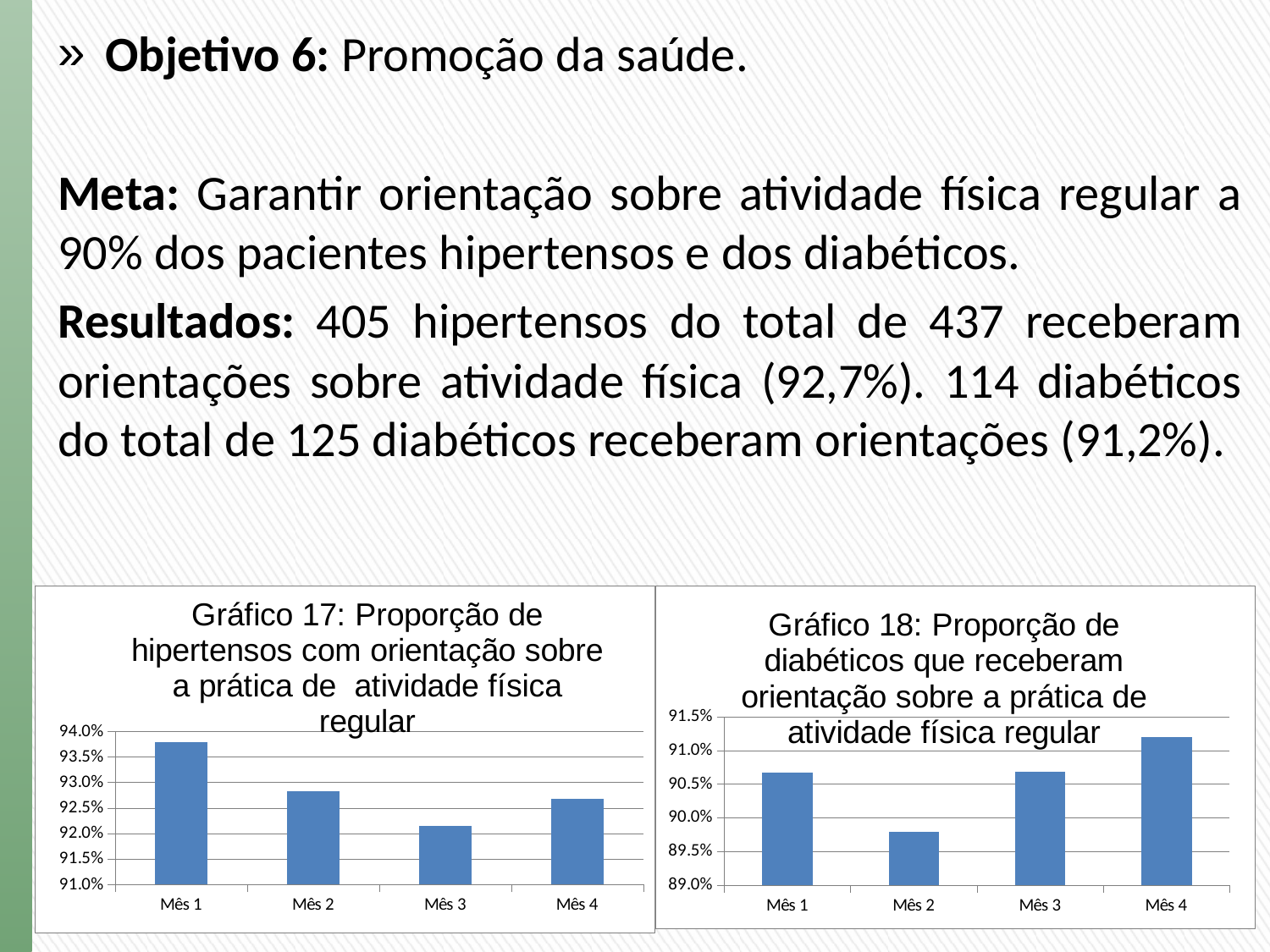
In Gráfico 17, is the value for Mês 1 greater or less than 93.5%? greater In Gráfico 17, which month has the highest proportion of hypertensive patients with guidance on physical activity? Mês 1 How many charts are shown on the slide? 2 In Gráfico 18, is the value for Mês 2 greater or less than 90.0%? less In Gráfico 18, which month has the highest proportion of diabetic patients who received guidance? Mês 4 In Gráfico 18, is the value for Mês 4 greater or less than 91.0%? greater In Gráfico 18, which month has the lowest proportion? Mês 2 In Gráfico 17, which is larger, the value for Mês 1 or the value for Mês 3? Mês 1 What kind of chart is Gráfico 17? bar chart In Gráfico 17, which month has the lowest proportion? Mês 3 In Gráfico 17, how many months are shown on the x axis? 4